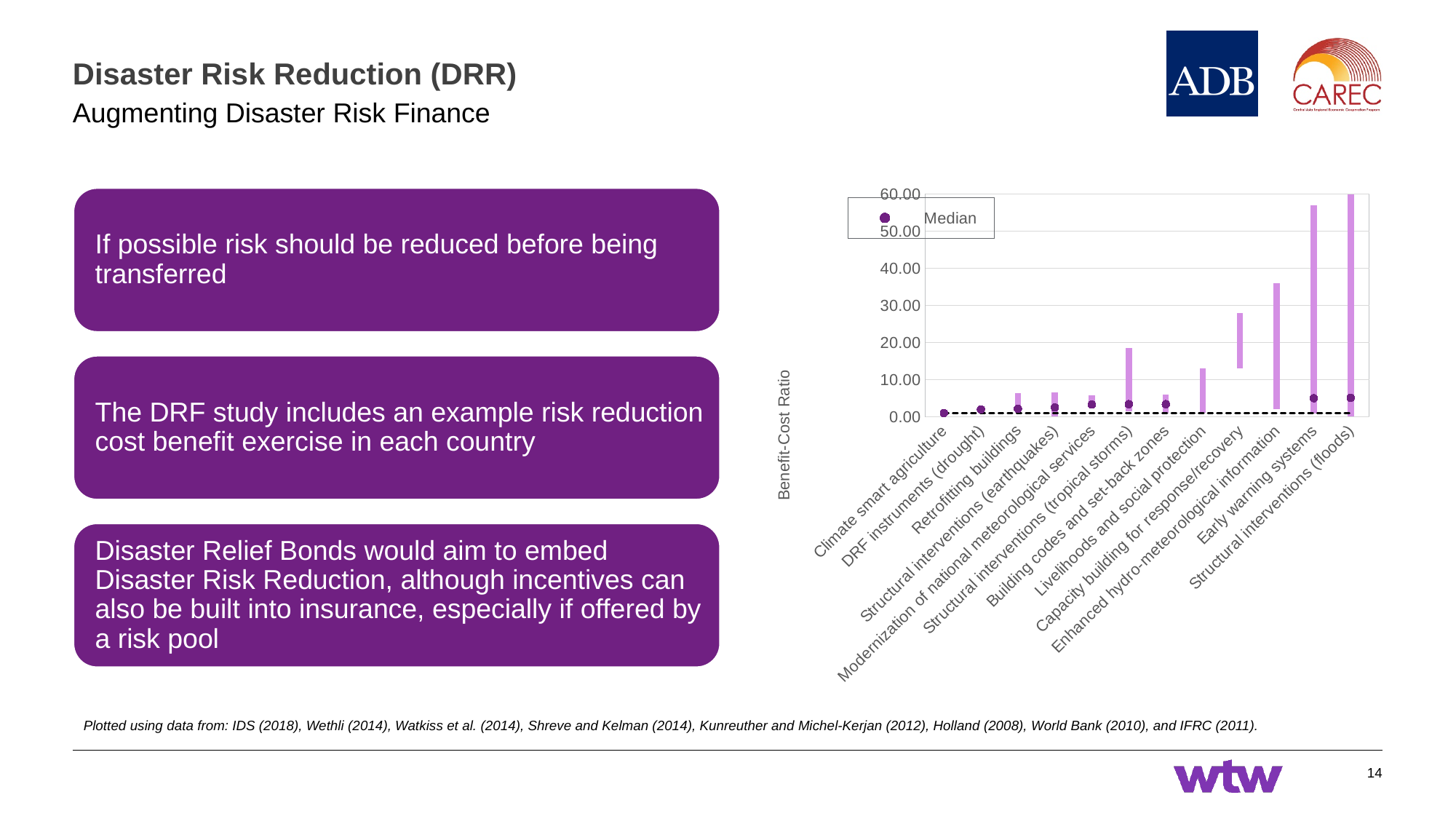
Is the top of the bar for Structural interventions (floods) greater or less than 50.00? greater Is the top of the bar for Livelihoods and social protection greater or less than 10.00? greater What entry does the chart's legend list? Median Is the top of the bar for Capacity building for response/recovery greater or less than 20.00? greater Which bar reaches higher: Enhanced hydro-meteorological information or Capacity building for response/recovery? Enhanced hydro-meteorological information What kind of chart is shown on the slide? bar chart How many categories are shown on the x axis of the chart? 12 Do the bar heights generally rise or fall moving left to right along the x axis? rise What is the label of the chart's vertical axis? Benefit-Cost Ratio